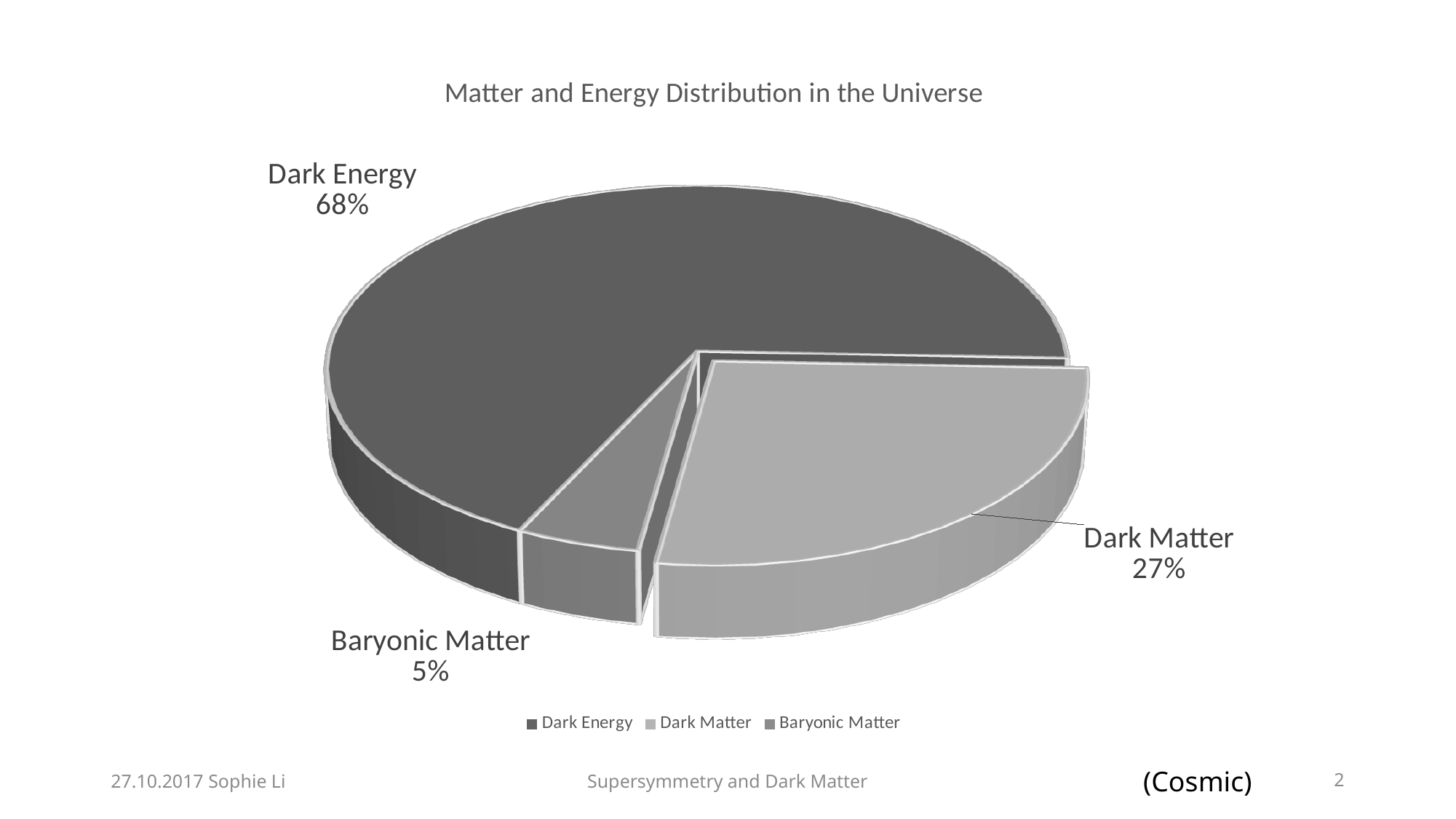
Which category has the largest slice of the pie? Dark Energy How many categories are shown in the pie chart? 3 What is the difference in percentage points between Dark Energy and Dark Matter? 41 What is the difference in percentage points between Dark Matter and Baryonic Matter? 22 Which is larger, the share for Dark Matter or the share for Baryonic Matter? Dark Matter What share of the pie does Baryonic Matter represent? 5% What share of the pie does Dark Matter represent? 27% What is the title of the chart? Matter and Energy Distribution in the Universe What kind of chart is shown on the slide? Pie chart What share of the pie does Dark Energy represent? 68% Which category has the smallest slice of the pie? Baryonic Matter How many entries does the legend list? 3